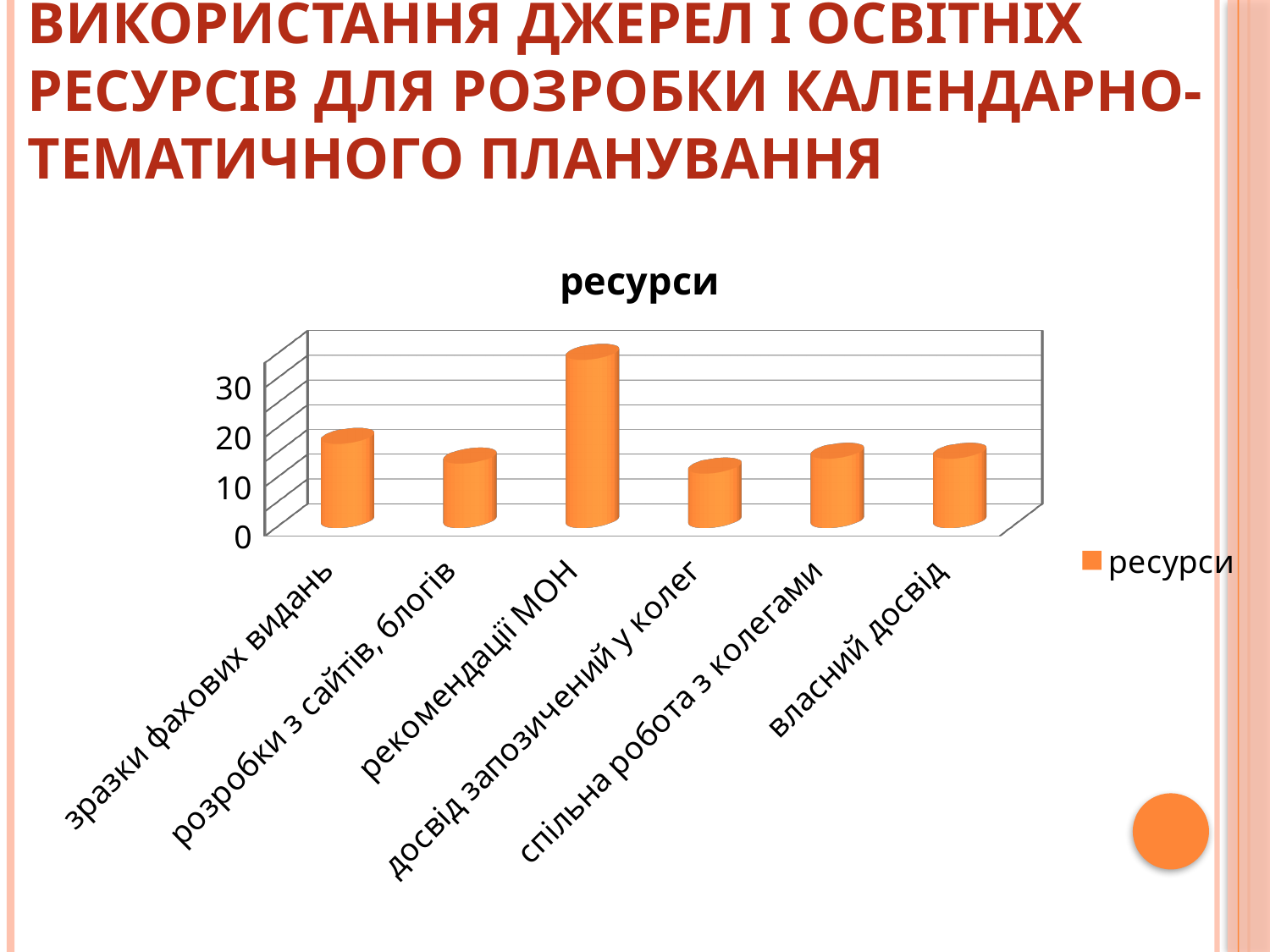
Is the value for розробки з сайтів, блогів greater or less than 20? less Is the value for досвід запозичений у колег greater or less than 20? less How many categories are shown on the x axis of the chart? 6 Which category has the highest value? рекомендації МОН What kind of chart is shown on the slide? bar chart What is the name of the series shown in the legend? ресурси Which is larger, the value for рекомендації МОН or the value for зразки фахових видань? рекомендації МОН Which is larger, the value for рекомендації МОН or the value for власний досвід? рекомендації МОН How many series does the legend list? 1 Is the value for зразки фахових видань greater or less than 10? greater What is the title of the chart? ресурси